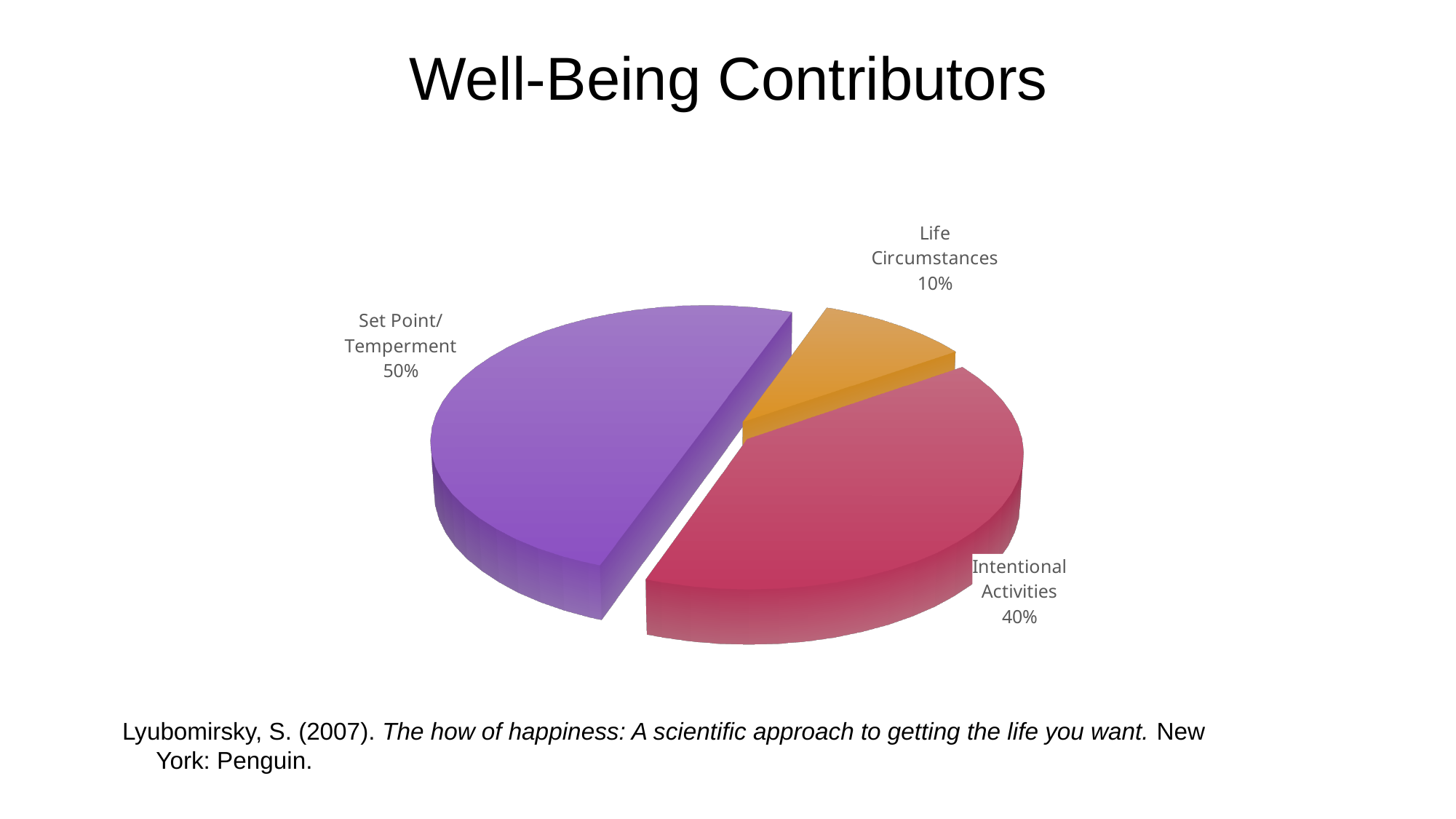
What is the difference in percentage points between Intentional Activities and Life Circumstances? 30% How many slices does the pie chart have? 3 Which is larger, the slice for Intentional Activities or the slice for Life Circumstances? Intentional Activities What share of the pie does Intentional Activities account for? 40% Which category has the smallest slice of the pie? Life Circumstances What share of the pie does Set Point/Temperment account for? 50% What is the title of the chart on the slide? Well-Being Contributors Which category has the largest slice of the pie? Set Point/Temperment What colour is the slice for Life Circumstances? Orange What is the difference in percentage points between Set Point/Temperment and Intentional Activities? 10% What kind of chart is shown on the slide? Pie chart What share of the pie does Life Circumstances account for? 10%